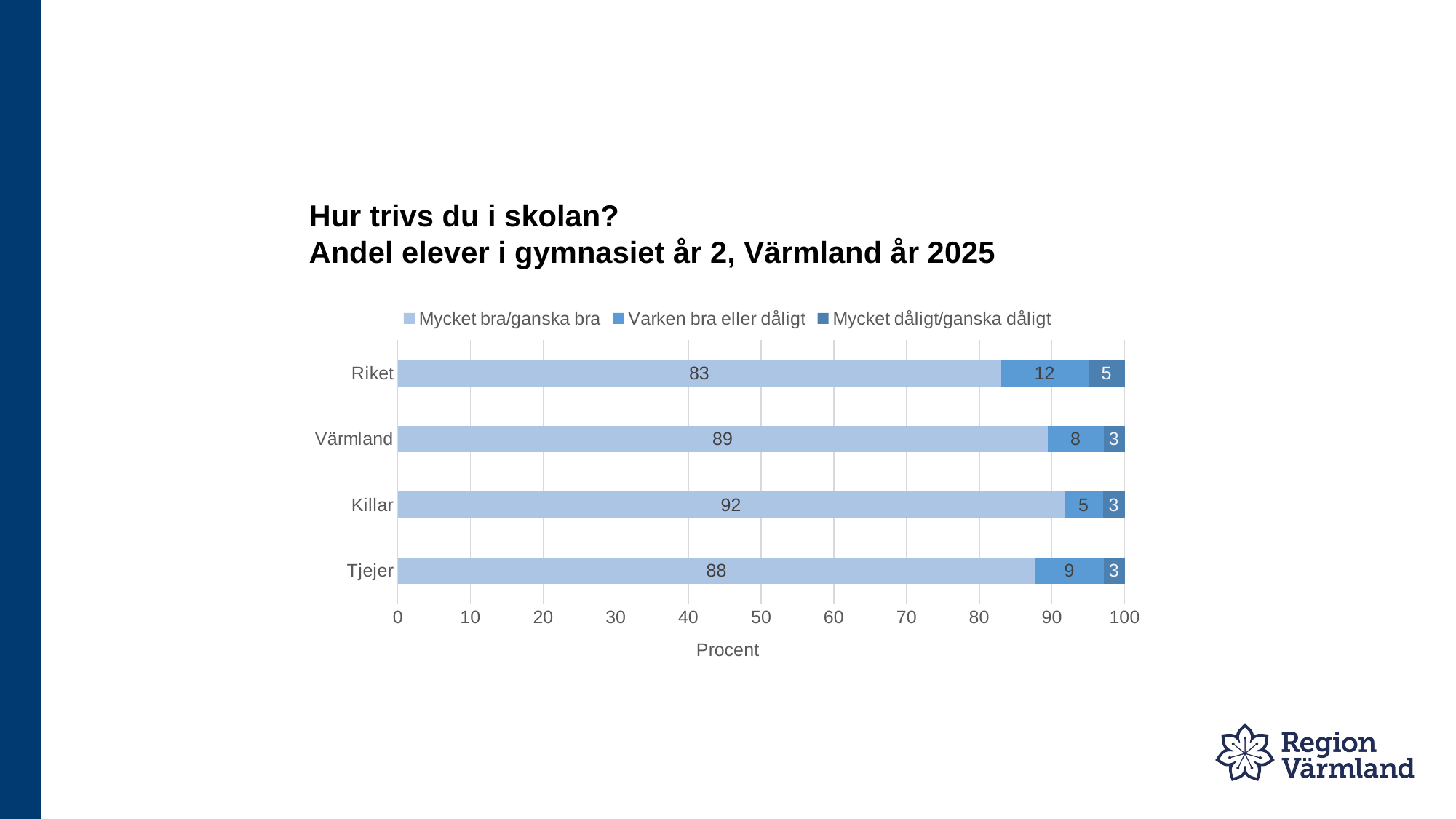
How many series does the legend list? 3 Which category has the highest value for 'Mycket bra/ganska bra'? Killar How many categories are shown on the chart? 4 Which category has the lowest value for 'Mycket bra/ganska bra'? Riket What kind of chart is shown on the slide? Stacked bar chart Which is larger: the 'Varken bra eller dåligt' value for Riket or for Tjejer? Riket What is the label of the x axis? Procent What is the value for 'Mycket bra/ganska bra' for Riket? 83 What is the difference between the 'Mycket bra/ganska bra' values for Killar and Tjejer? 4 What is the value for 'Mycket dåligt/ganska dåligt' for Tjejer? 3 What is the value for 'Varken bra eller dåligt' for Värmland? 8 What is the total of the stacked bar for Riket? 100